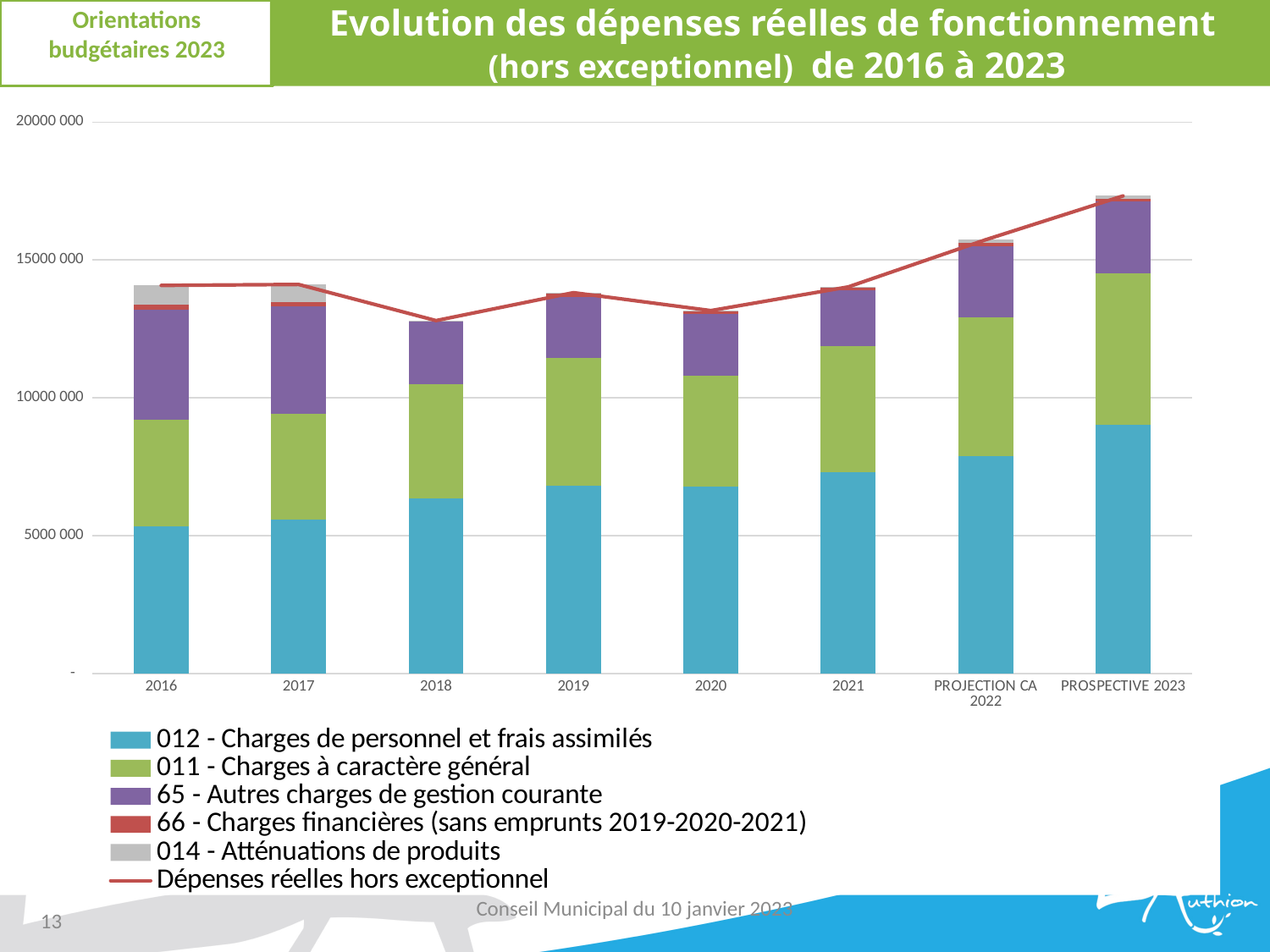
Does the line 'Dépenses réelles hors exceptionnel' rise or fall from 2021 to PROSPECTIVE 2023? rise Is the total stacked bar for 2018 greater or less than 15000 000? less How many categories are shown along the x axis? 8 Is the total stacked bar for PROSPECTIVE 2023 greater or less than 15000 000? greater How many series does the legend list? 6 Which series is shown in purple in the legend? 65 - Autres charges de gestion courante Which has the larger total stacked bar, 2016 or PROSPECTIVE 2023? PROSPECTIVE 2023 What kind of chart is shown on the slide? stacked bar chart with a line Is the value of '012 - Charges de personnel et frais assimilés' for 2016 greater or less than 10000 000? less Which category has the highest total stacked bar? PROSPECTIVE 2023 Which category has the lowest total stacked bar? 2018 What is the title of the chart? Evolution des dépenses réelles de fonctionnement (hors exceptionnel) de 2016 à 2023